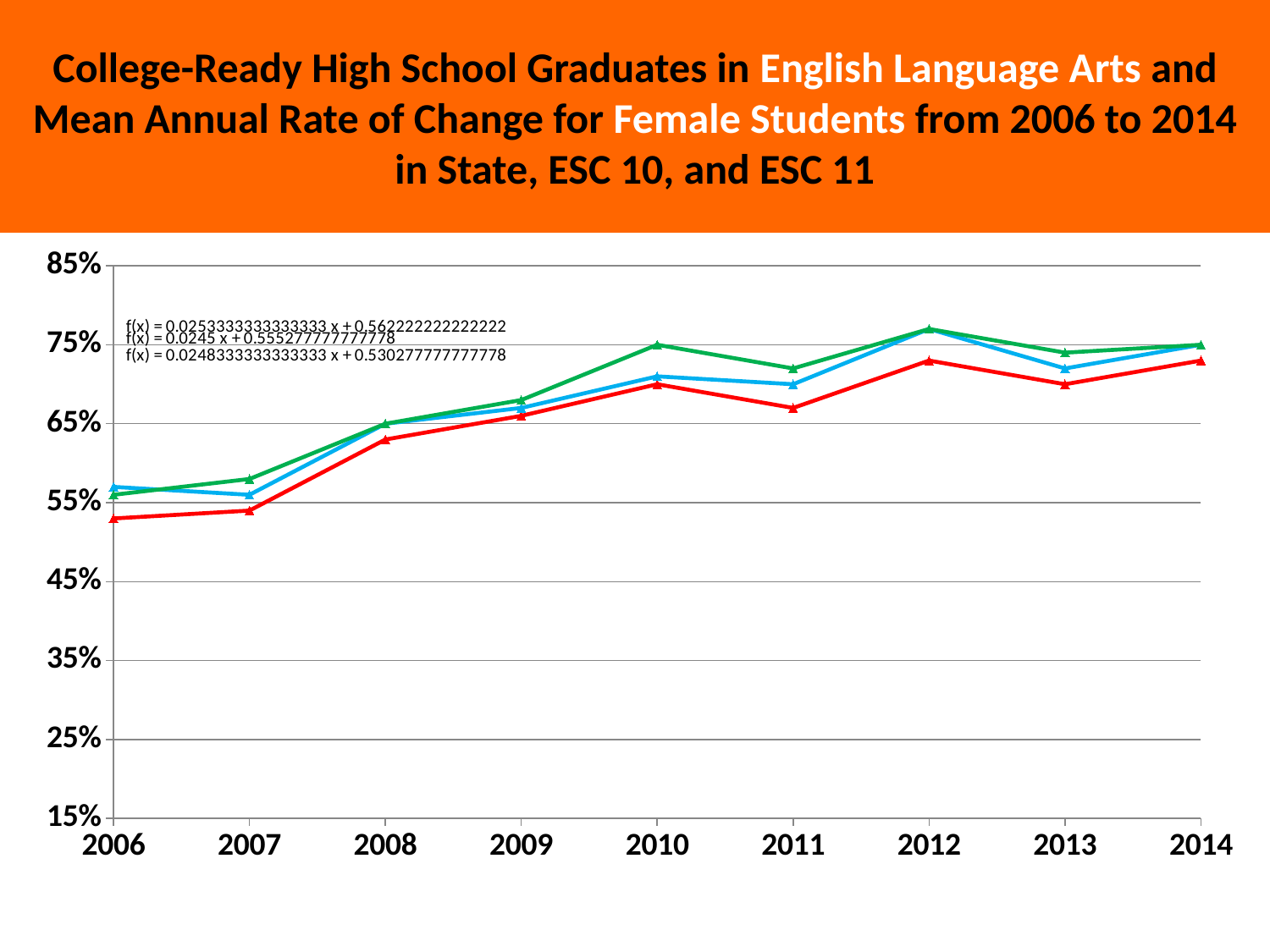
Is the value of the blue line in 2011 greater or less than 65%? greater Is the value of the red line in 2006 greater or less than 55%? less Is the value of the red line in 2014 greater or less than 75%? less How many years are shown along the x axis of the chart? 9 What is the first year shown on the x axis of the chart? 2006 In 2013, which line is higher, the red line or the green line? green What kind of chart is shown on the slide? line chart In which year does the green line reach its highest value? 2012 Overall, do the plotted values rise or fall from 2006 to 2014? rise How many lines are plotted on the chart? 3